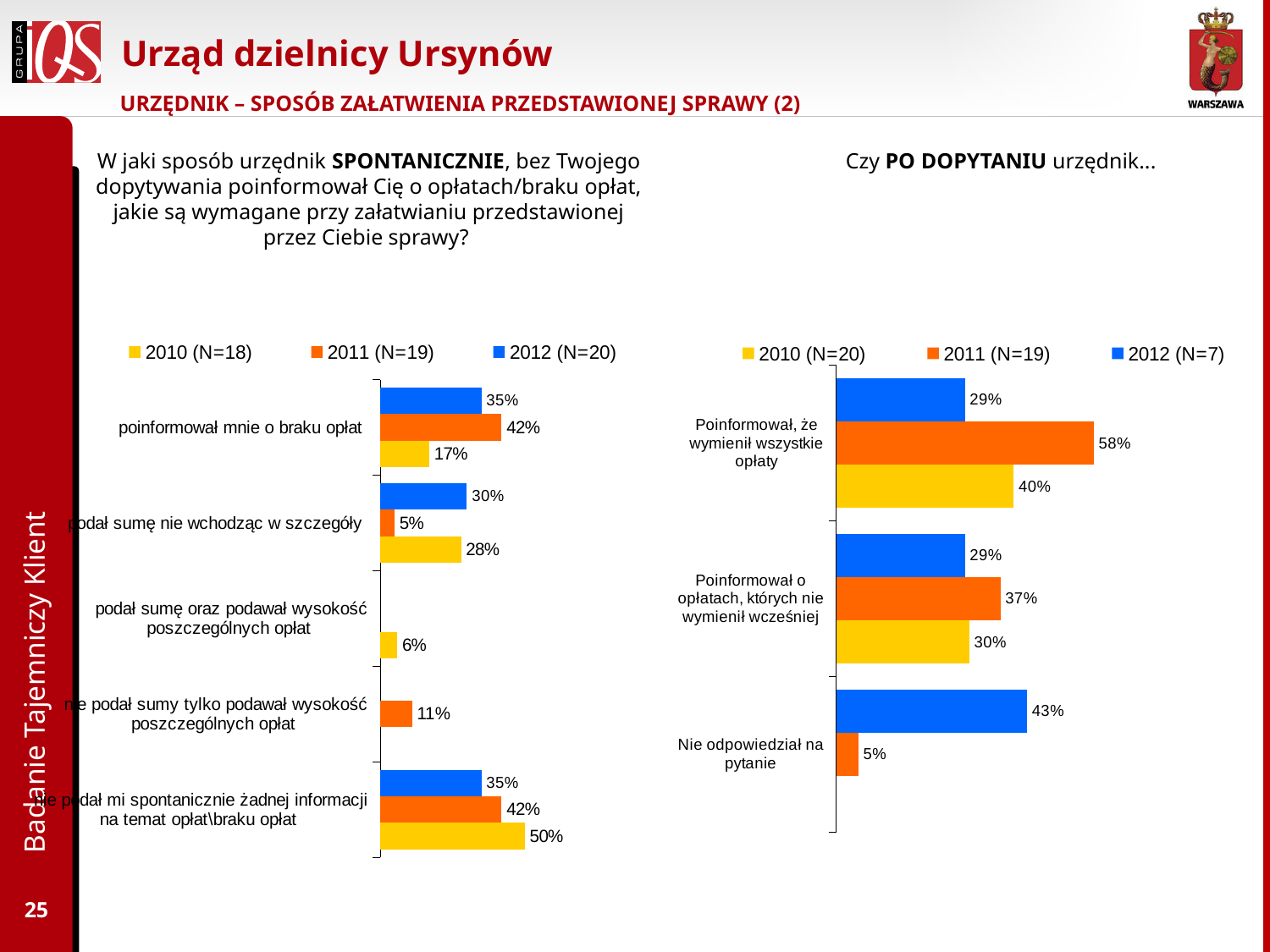
In the right chart (PO DOPYTANIU), which year has the lowest value for 'Poinformował, że wymienił wszystkie opłaty'? 2012 (N=7) In the left chart (SPONTANICZNIE), what is the 2011 (N=19) value for 'poinformował mnie o braku opłat'? 42% In the right chart (PO DOPYTANIU), is the 2011 value for 'Poinformował o opłatach, których nie wymienił wcześniej' larger or smaller than the 2010 value? larger In the left chart (SPONTANICZNIE), how many categories are shown? 5 In the right chart (PO DOPYTANIU), what is the 2012 (N=7) value for 'Nie odpowiedział na pytanie'? 43% In the left chart (SPONTANICZNIE), what is the difference between the 2012 and 2011 values for 'podał sumę nie wchodząc w szczegóły'? 25 percentage points In the left chart (SPONTANICZNIE), which year has the highest value for 'nie podał mi spontanicznie żadnej informacji na temat opłat\braku opłat'? 2010 (N=18) In the right chart (PO DOPYTANIU), what is the 2011 (N=19) value for 'Poinformował, że wymienił wszystkie opłaty'? 58% How many series does the legend of the right chart (PO DOPYTANIU) list? 3 What type of chart is the left chart (SPONTANICZNIE)? Bar chart In the left chart (SPONTANICZNIE), what is the 2010 (N=18) value for 'podał sumę nie wchodząc w szczegóły'? 28% In the right chart (PO DOPYTANIU), what is the difference between the 2011 and 2010 values for 'Poinformował, że wymienił wszystkie opłaty'? 18 percentage points